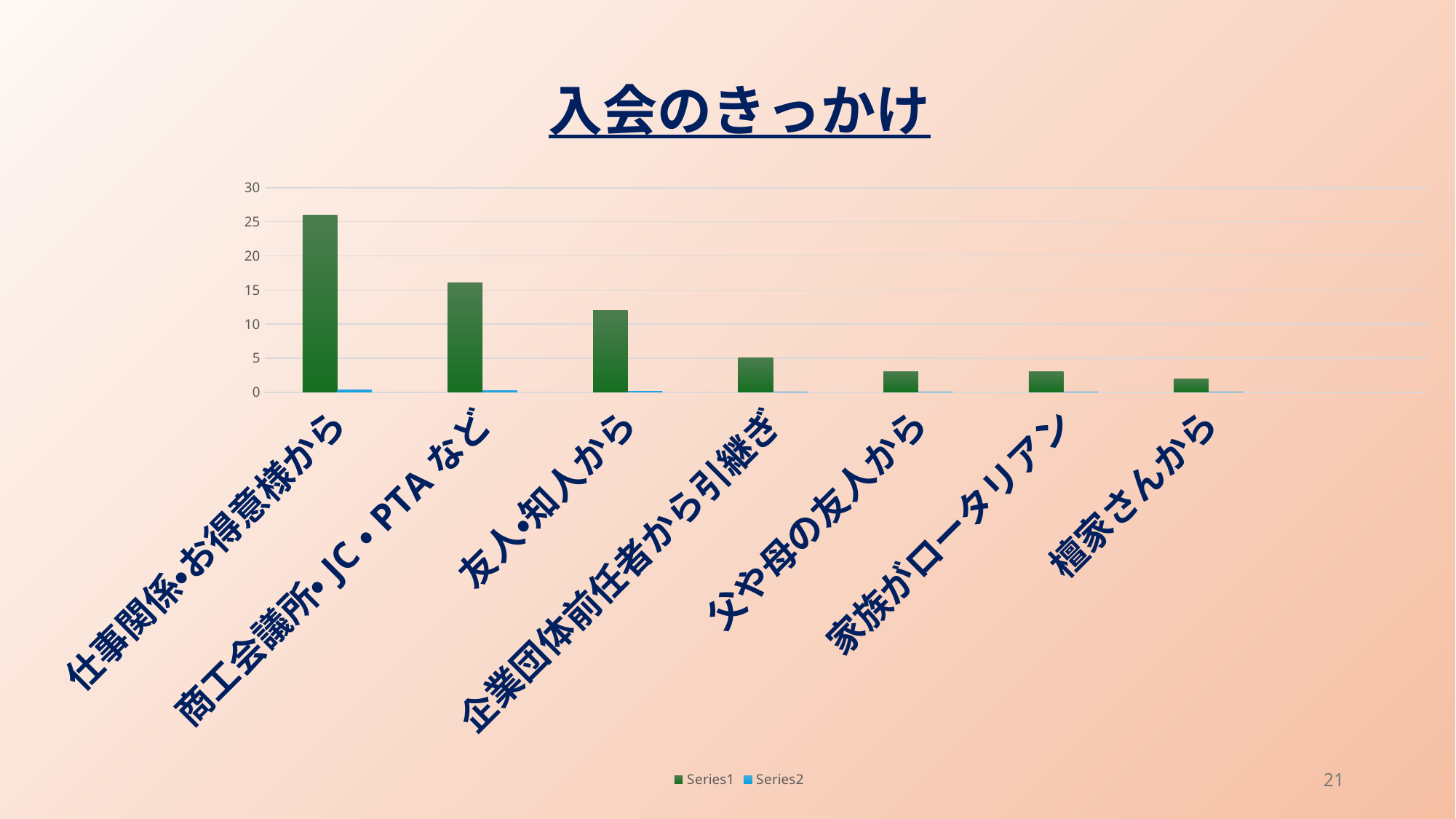
Which category has the highest Series1 value? 仕事関係•お得意様から Is the Series1 value for 父や母の友人から greater or less than 5? less What kind of chart is shown on the slide? bar chart Which has the larger Series1 value, 商工会議所• JC・PTA など or 友人•知人から? 商工会議所• JC・PTA など What is the title of the chart? 入会のきっかけ Do the Series1 values rise or fall from left to right along the x axis? fall How many categories are shown on the x axis of the chart? 7 Is the Series1 value for 友人•知人から greater or less than 10? greater How many series does the legend list? 2 Is the Series1 value for 仕事関係•お得意様から greater or less than 20? greater Which category has the lowest Series1 value? 檀家さんから